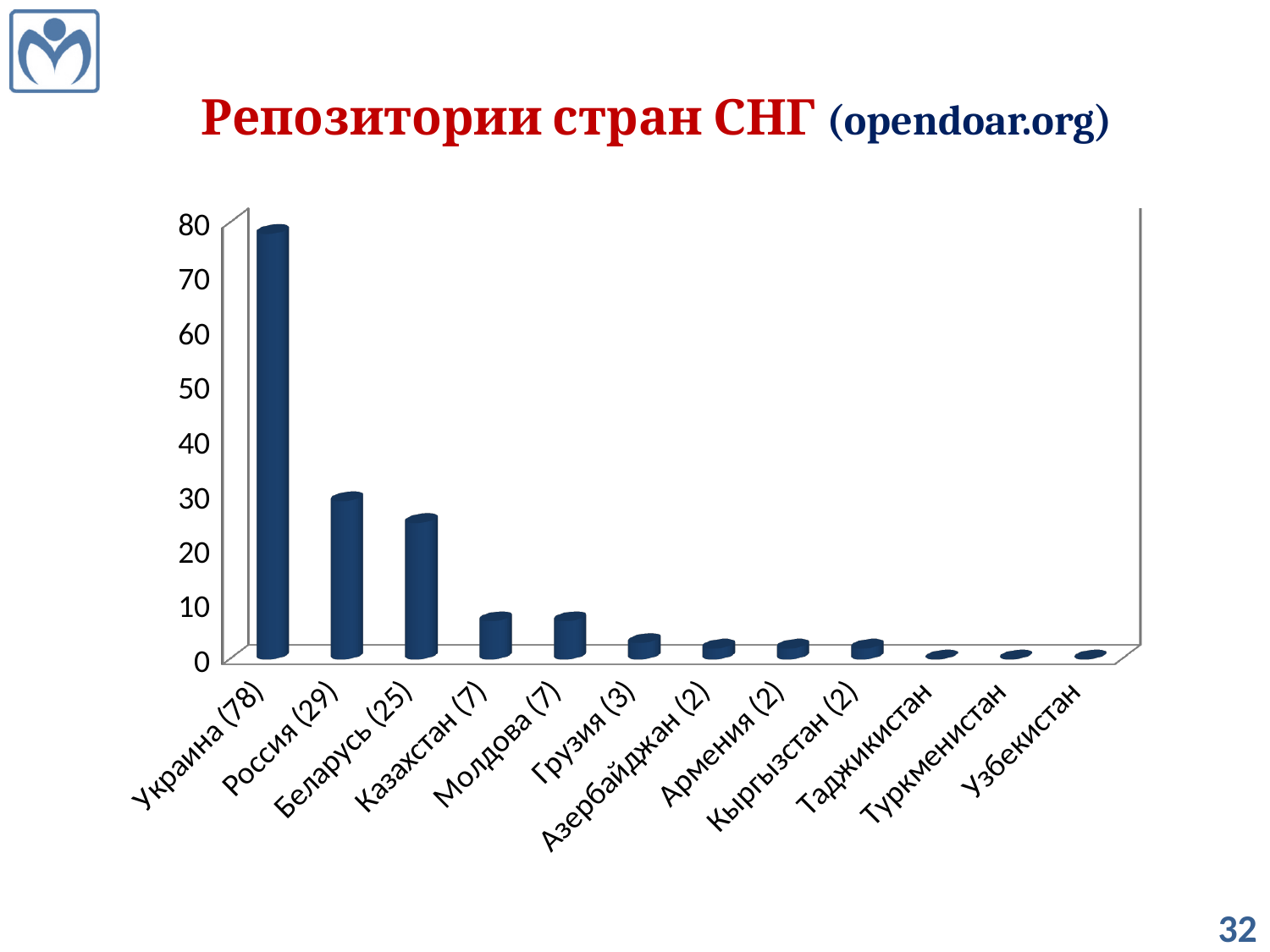
How many repositories does Грузия have according to the chart? 3 What kind of chart is shown on the slide? Bar chart How many repositories does Россия have according to the chart? 29 Which has more repositories, Казахстан or Грузия? Казахстан How many repositories does Беларусь have according to the chart? 25 Do the bar values rise or fall from left to right along the x axis? Fall Is the value for Украина greater or less than 70? greater What is the difference between the number of repositories for Россия and Беларусь? 4 Which country has the highest number of repositories in the chart? Украина What is the difference between the number of repositories for Украина and Россия? 49 How many countries (categories) are shown on the x axis of the chart? 12 What is the title of the chart on the slide? Репозитории стран СНГ (opendoar.org)